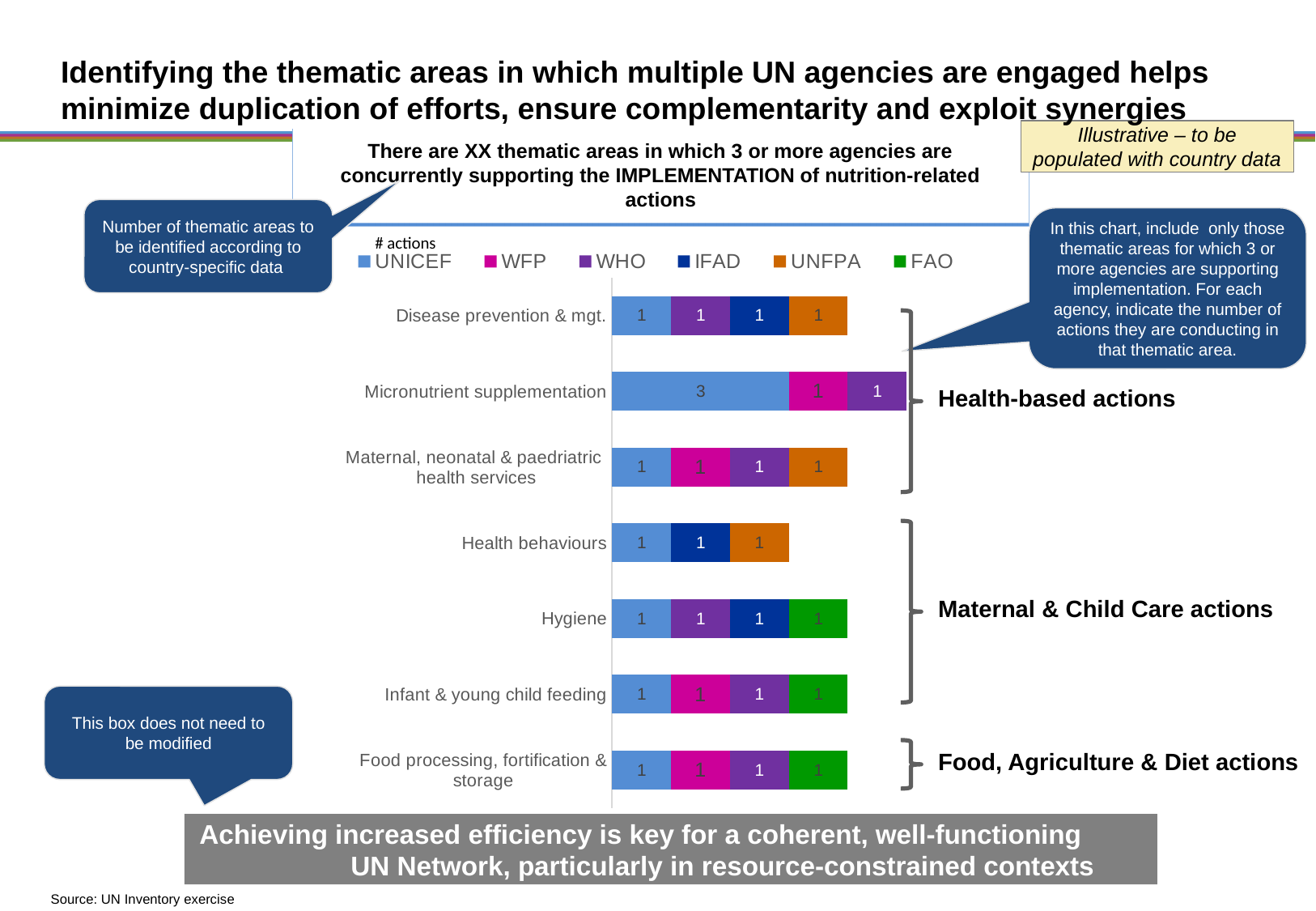
Which agency is represented by the green colour in the chart legend? FAO How many thematic areas (categories) are plotted in the chart? 7 What is the difference between UNICEF's actions in Micronutrient supplementation and UNICEF's actions in Hygiene? 2 How many actions does UNFPA have in the Health behaviours thematic area? 1 Which thematic area has the highest total number of actions? Micronutrient supplementation Which thematic area has the lowest total number of actions? Health behaviours Which bar is longer in total: Micronutrient supplementation or Health behaviours? Micronutrient supplementation What is the total number of actions in the Health behaviours bar? 3 How many series does the chart legend list? 6 What is the total number of actions in the Micronutrient supplementation bar? 5 How many actions does UNICEF have in the Micronutrient supplementation thematic area? 3 What type of chart is shown on the slide? Stacked bar chart